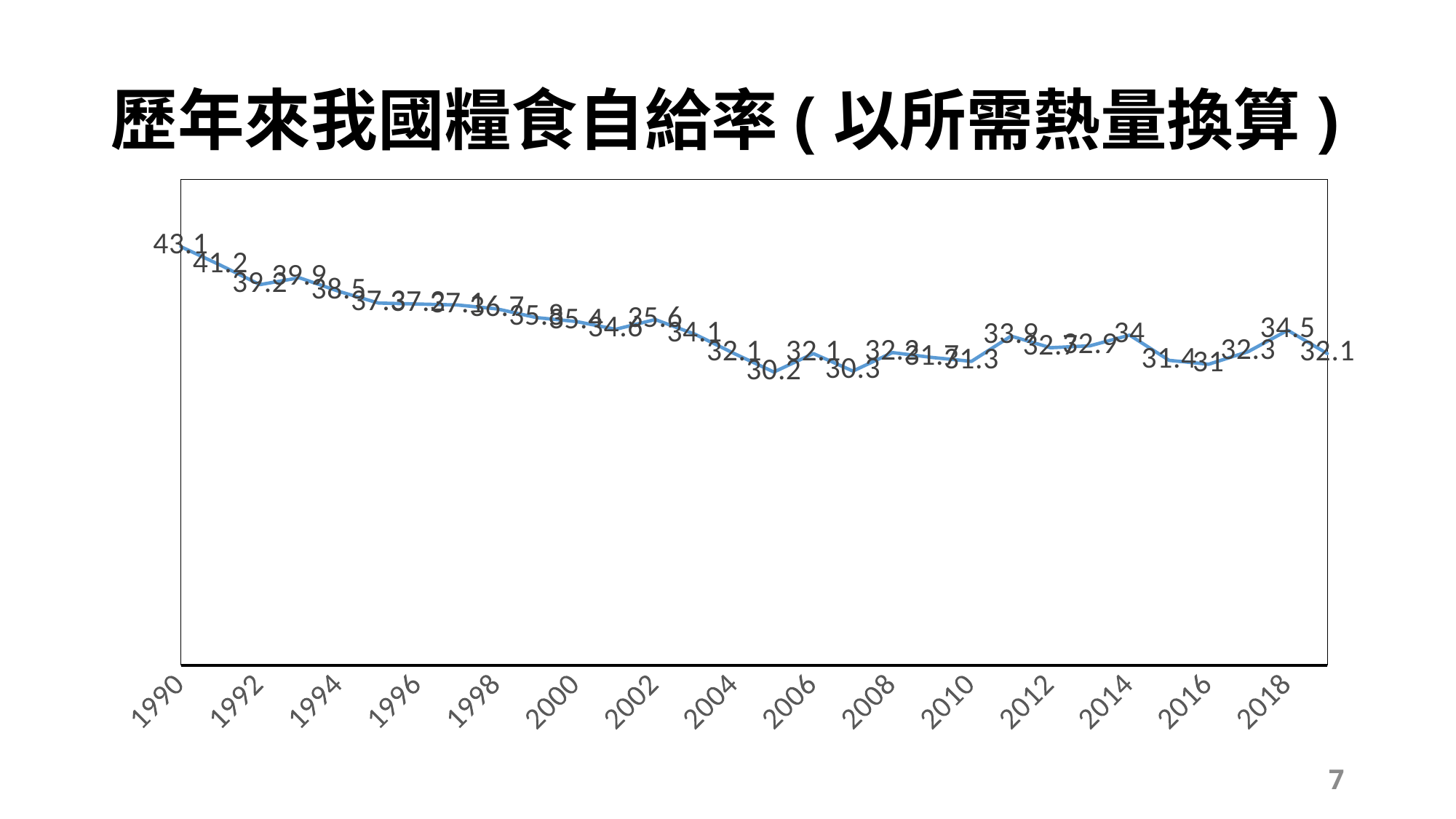
Which is larger, the value for 1990 or the value of the last point on the line? 1990 What is the title of the chart? 歷年來我國糧食自給率（以所需熱量換算） What is the lowest value shown on the line? 30.2 What is the highest value shown on the line? 43.1 What is the first year shown on the x axis? 1990 Overall, do the values rise or fall from 1990 to the end of the series? fall What is the difference between the value for 1990 and the value of the last point on the line? 11 What kind of chart is shown on the slide? line chart What is the value plotted for 1990? 43.1 Which year has the highest value on the chart? 1990 What is the value of the last (rightmost) point on the line? 32.1